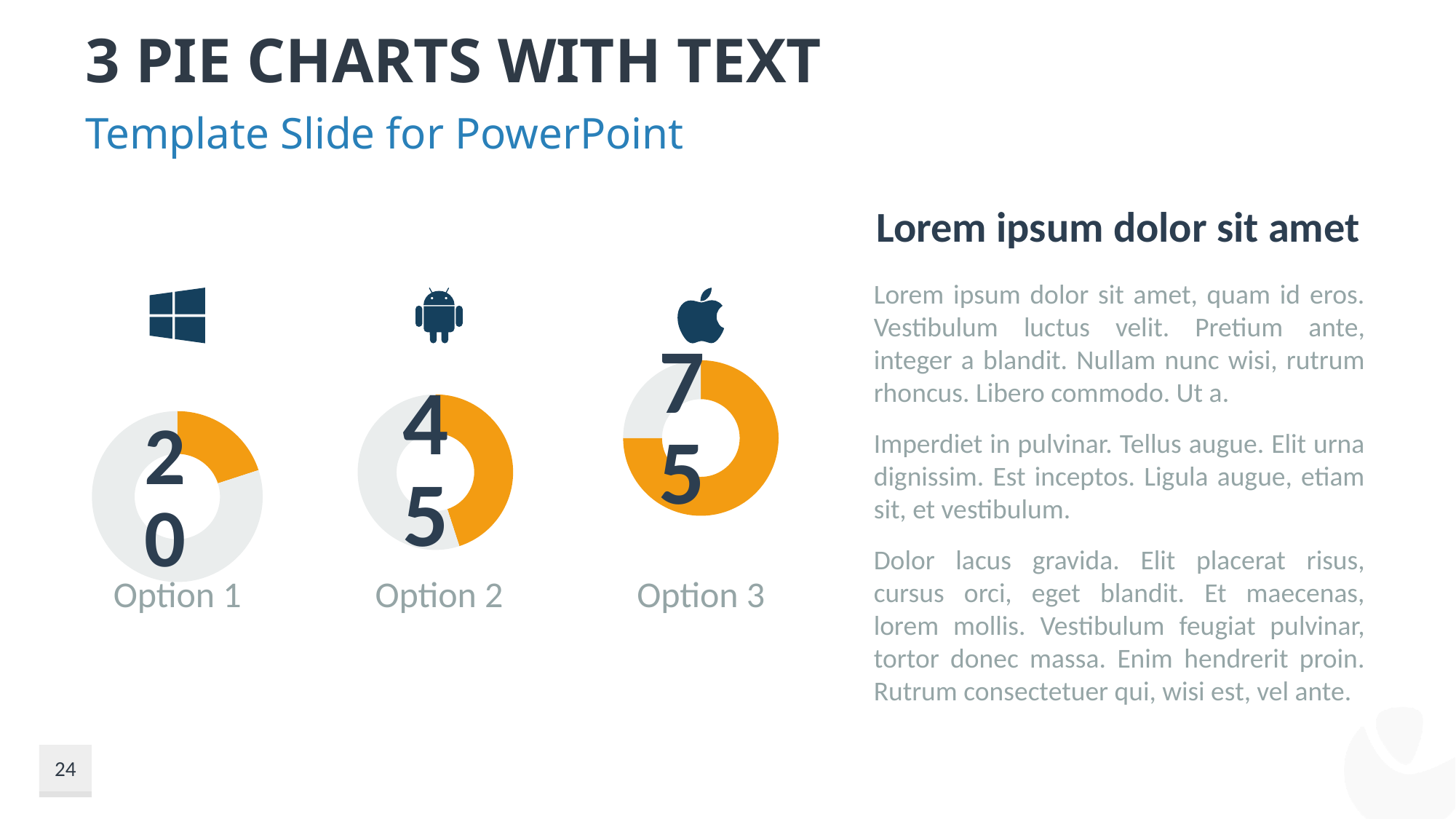
What colour is the filled portion of each chart? Orange What value is shown in the centre of the Option 3 chart? 75 What is the difference between the values for Option 2 and Option 1? 25 What kind of chart is used for each option on the slide? Pie (donut) chart Which has the larger value, Option 2 or Option 3? Option 3 How many charts are shown on the slide? 3 Which option has the highest value across the three charts? Option 3 What is the difference between the values for Option 3 and Option 1? 55 Which option has the lowest value across the three charts? Option 1 What value is shown in the centre of the Option 2 chart? 45 What value is shown in the centre of the Option 1 chart? 20 Which icon appears above the Option 1 chart? Windows logo